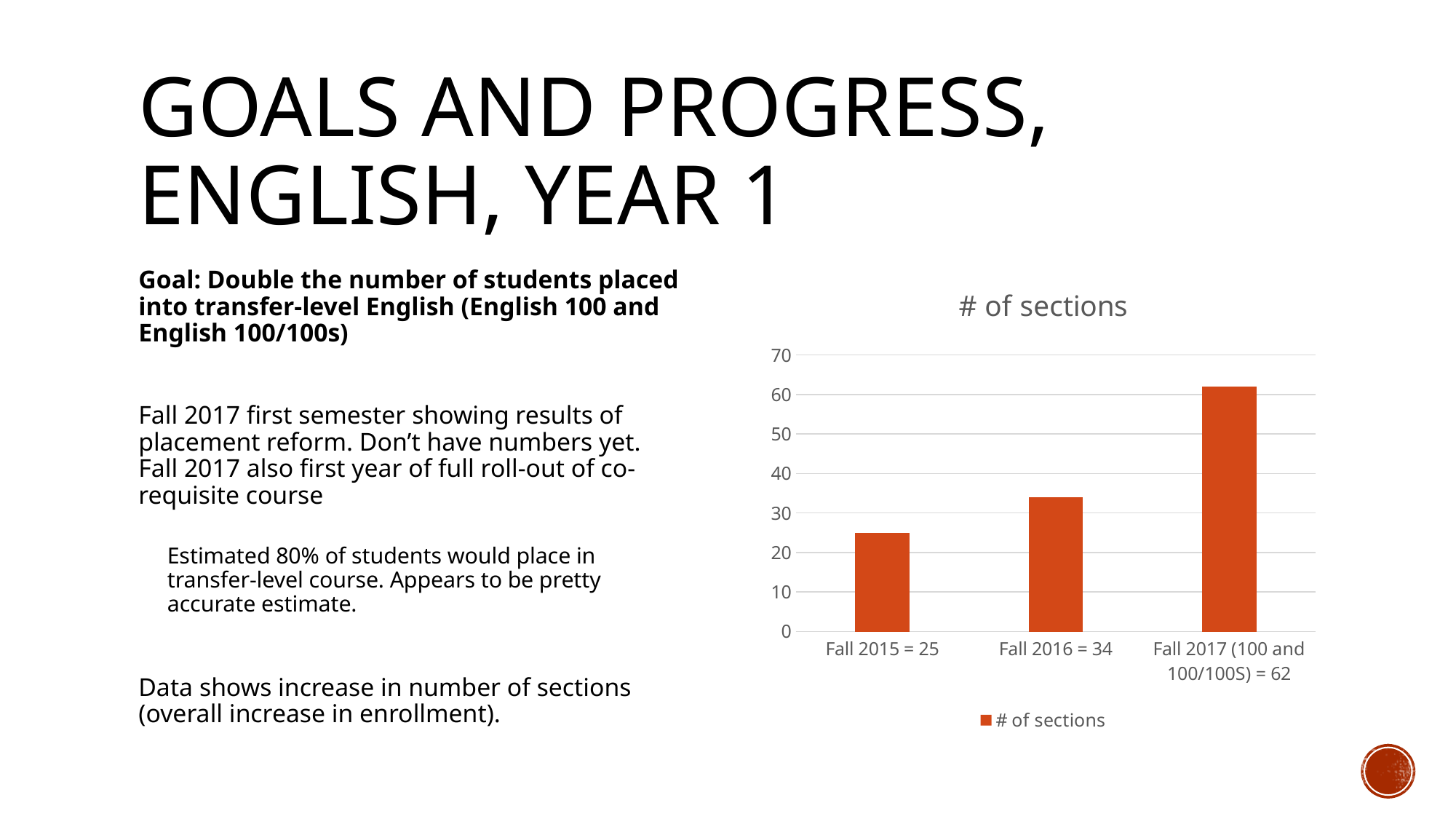
What is the number of sections for Fall 2017 (100 and 100/100S)? 62 How many series does the legend list? 1 What kind of chart is shown on the slide? bar chart What is the difference in number of sections between Fall 2017 and Fall 2016? 28 Do the values rise or fall from Fall 2015 to Fall 2017? rise Which category has the highest number of sections? Fall 2017 (100 and 100/100S) What is the number of sections for Fall 2015? 25 What is the number of sections for Fall 2016? 34 How many bars does the chart have? 3 What is the title of the chart? # of sections Which has more sections, Fall 2015 or Fall 2016? Fall 2016 Which category has the lowest number of sections? Fall 2015